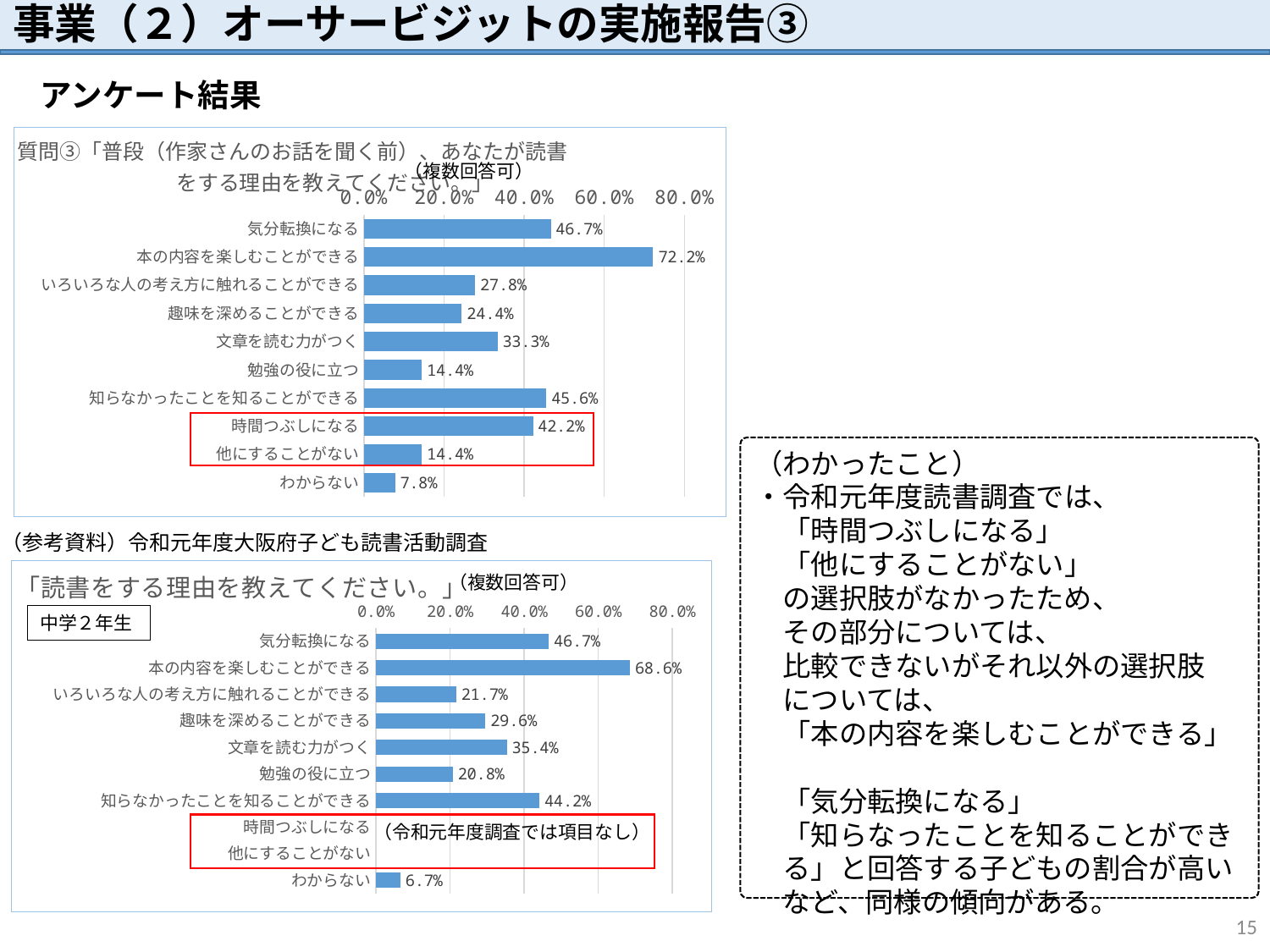
In the top chart (質問③), what is the value for 本の内容を楽しむことができる? 72.2% In the bottom chart (令和元年度大阪府子ども読書活動調査), which is larger: 趣味を深めることができる or いろいろな人の考え方に触れることができる? 趣味を深めることができる In the top chart (質問③), how many categories are shown? 10 In the bottom chart (令和元年度大阪府子ども読書活動調査), what is the difference between 文章を読む力がつく and 勉強の役に立つ? 14.6% In the top chart (質問③), which category has the highest value? 本の内容を楽しむことができる In the top chart (質問③), what is the difference between 気分転換になる and 知らなかったことを知ることができる? 1.1% In the top chart (質問③), which category has the lowest value? わからない In the bottom chart (令和元年度大阪府子ども読書活動調査), what is the value for 本の内容を楽しむことができる? 68.6% What type of chart is the top chart (質問③)? Bar chart In the top chart (質問③), what is the value for 時間つぶしになる? 42.2% In the bottom chart, which grade of students is indicated in the box at the top left? 中学２年生 In the bottom chart (令和元年度大阪府子ども読書活動調査), what is the value for 勉強の役に立つ? 20.8%